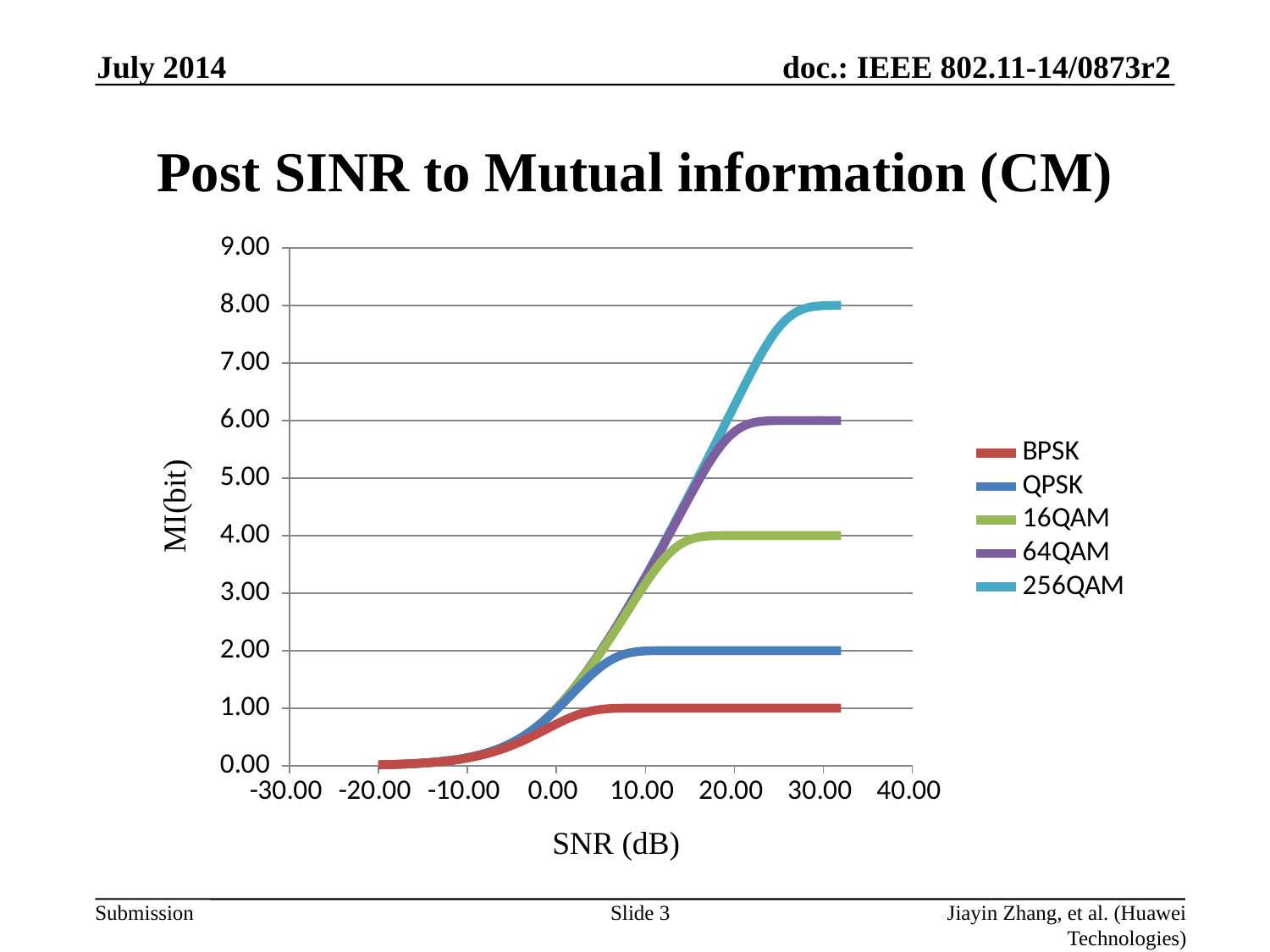
Which series reaches the highest MI value? 256QAM At an SNR of 30.00 dB, is the value for 256QAM greater or less than 7.00? greater How many series does the legend list? 5 At what MI value does the 16QAM curve level off? 4.00 What is the label of the x axis? SNR (dB) At what MI value does the 256QAM curve level off? 8.00 What is the title of the chart? Post SINR to Mutual information (CM) Which series saturates at the lowest MI value? BPSK Do the MI values rise or fall as SNR increases? rise What kind of chart is shown on the slide? line chart At what MI value does the 64QAM curve level off? 6.00 At an SNR of 30.00 dB, which is larger, the value for 64QAM or the value for 16QAM? 64QAM